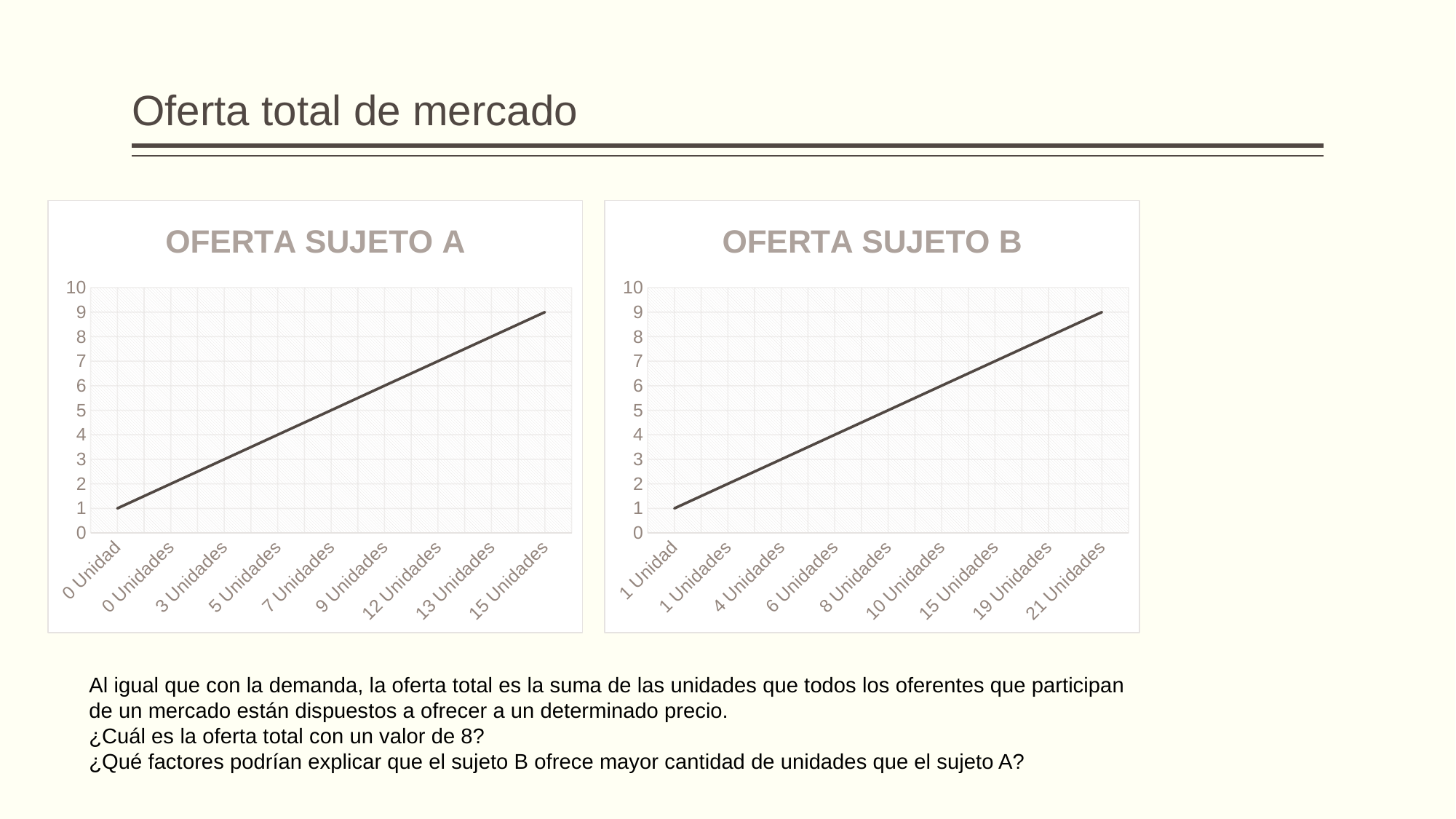
In the 'OFERTA SUJETO A' chart, which category has the lowest value? 0 Unidad In the 'OFERTA SUJETO A' chart, is the value for '3 Unidades' greater or less than 5? less In the 'OFERTA SUJETO A' chart, what is the difference between the value at '15 Unidades' and the value at '0 Unidad'? 8 How many categories are shown on the x axis of the 'OFERTA SUJETO B' chart? 9 In the 'OFERTA SUJETO B' chart, what is the value at '21 Unidades'? 9 In the 'OFERTA SUJETO B' chart, which category has the highest value? 21 Unidades In the 'OFERTA SUJETO A' chart, do the values rise or fall along the x axis? rise What kind of chart is the 'OFERTA SUJETO A' chart? line chart In the 'OFERTA SUJETO B' chart, is the value for '15 Unidades' greater or less than 5? greater In the 'OFERTA SUJETO B' chart, what is the value at '1 Unidad'? 1 In the 'OFERTA SUJETO A' chart, what is the value at '0 Unidad'? 1 In the 'OFERTA SUJETO A' chart, what is the value at '15 Unidades'? 9